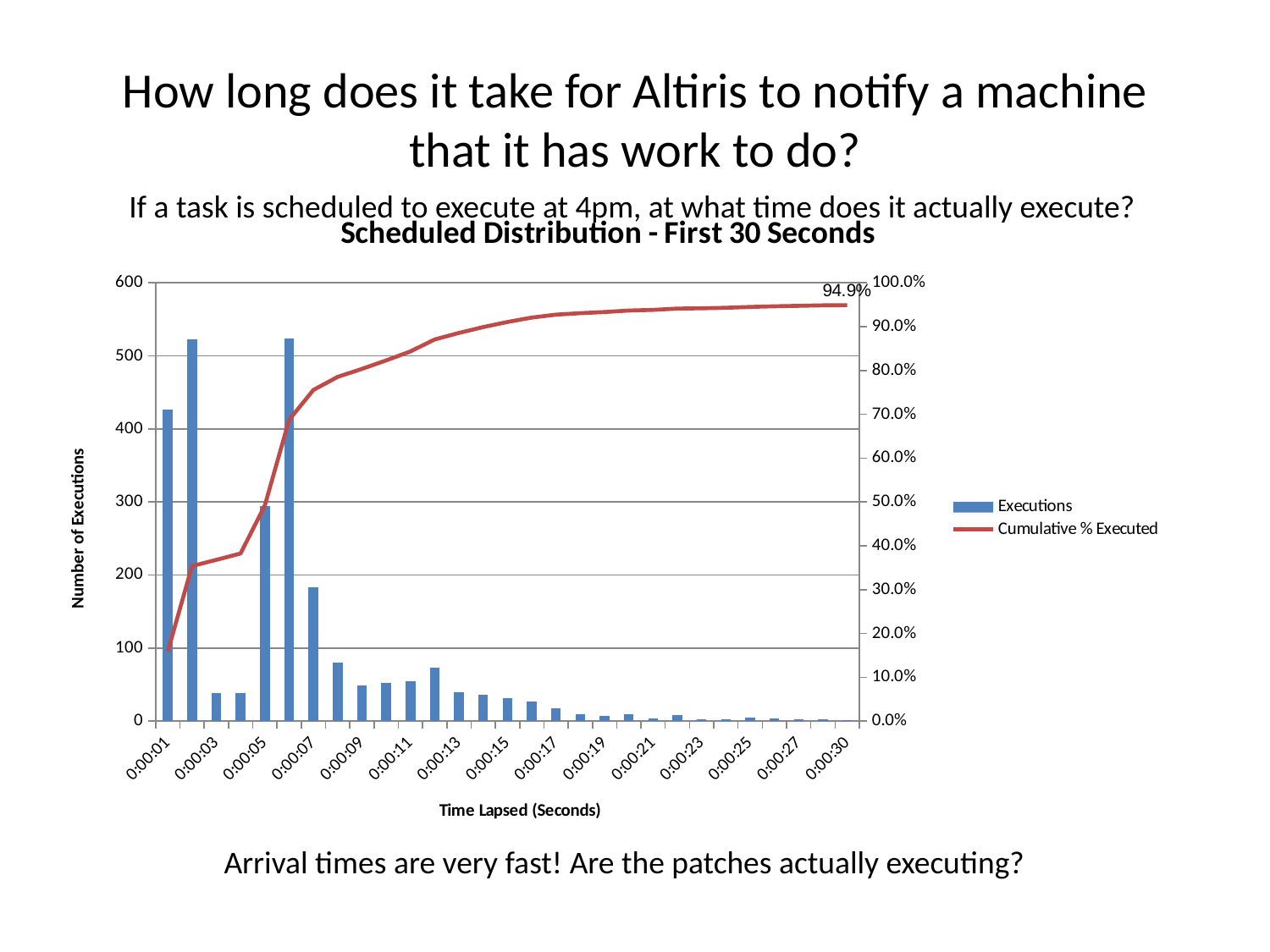
Is the Cumulative % Executed at 0:00:01 greater or less than 20.0%? less Is the number of Executions at 0:00:07 greater or less than 200? less How many series does the chart legend list? 2 What is the title of the chart? Scheduled Distribution - First 30 Seconds Is the Cumulative % Executed at 0:00:07 greater or less than 70.0%? greater What kind of chart is shown on the slide? Combined bar and line chart Does the Cumulative % Executed line rise or fall as time lapsed increases? rises Which has more Executions, 0:00:01 or 0:00:07? 0:00:01 What is the Cumulative % Executed value labelled at 0:00:30? 94.9% What is the title of the x axis? Time Lapsed (Seconds)